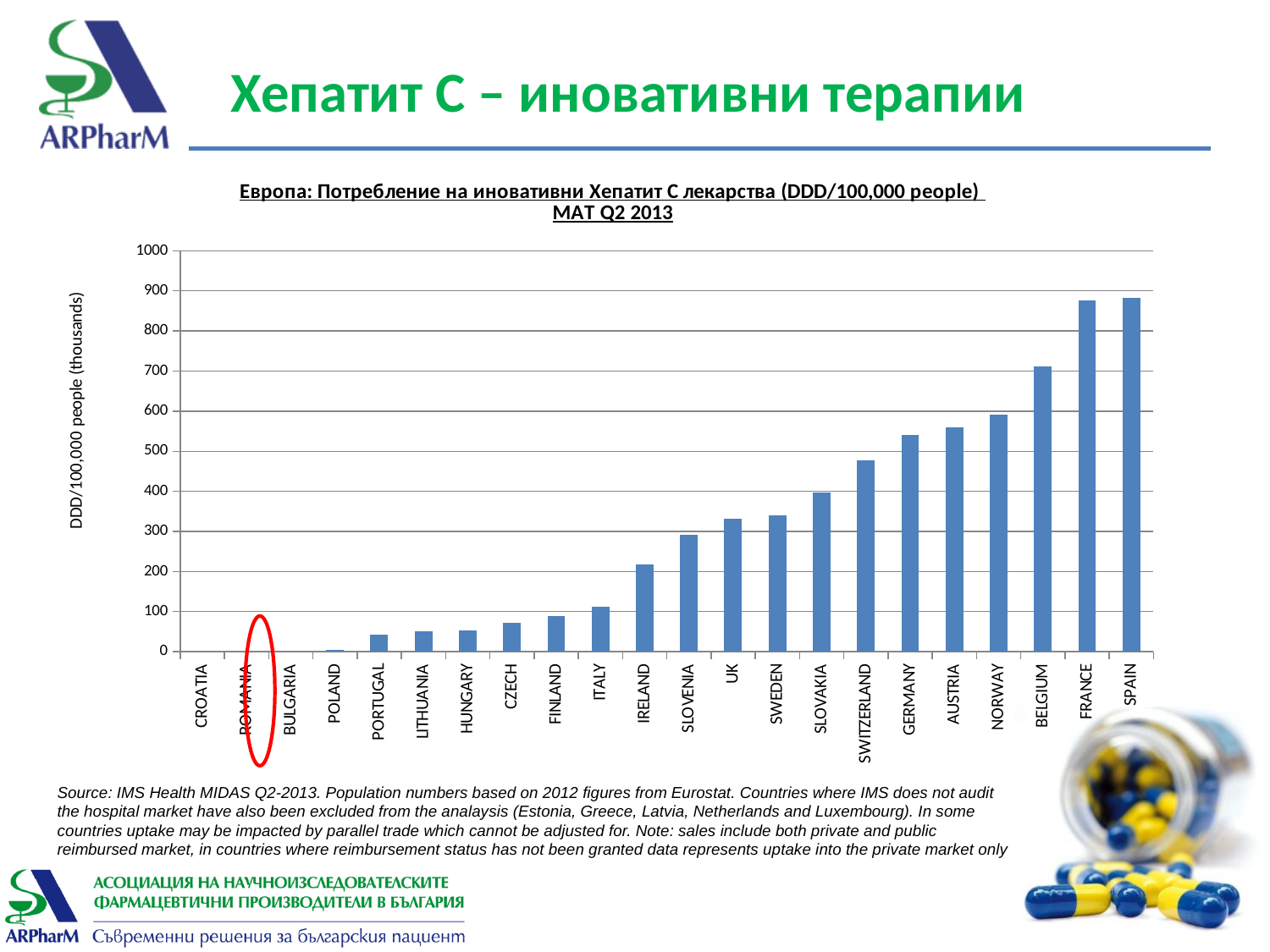
Is the value for Finland greater or less than 100? less What kind of chart is shown on the slide? bar chart Which country's label is circled in red on the chart? Romania Which has the larger value, Italy or Slovenia? Slovenia Is the value for Ireland greater or less than 200? greater How many countries are shown on the x axis of the chart? 22 Which has the larger value, Belgium or Norway? Belgium Is the value for Germany greater or less than 500? greater What is the label on the vertical axis of the chart? DDD/100,000 people (thousands) Do the values generally rise or fall moving from left to right along the x axis? rise